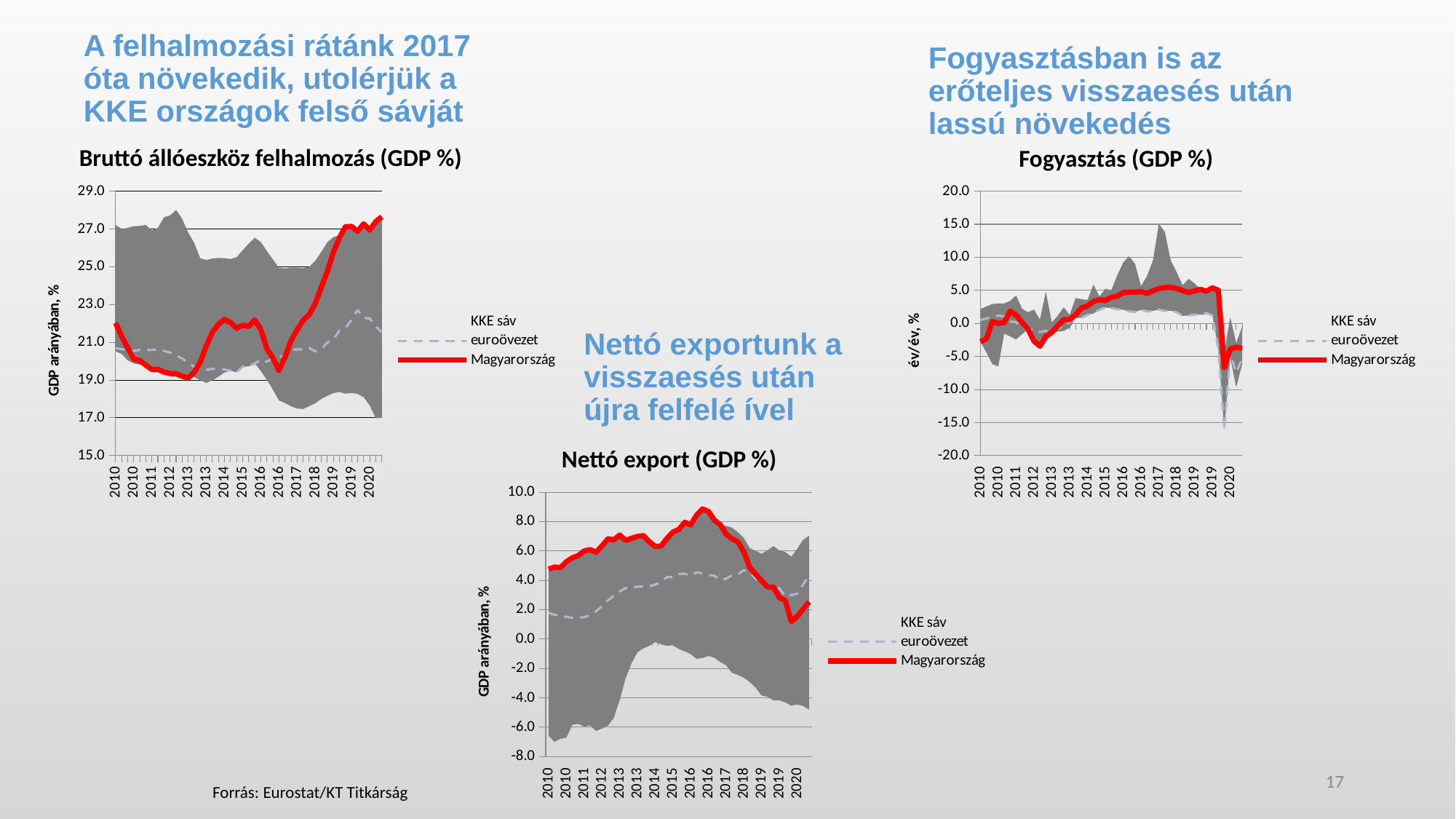
What kind of chart is the 'Bruttó állóeszköz felhalmozás (GDP %)' chart? combination area and line chart In the 'Bruttó állóeszköz felhalmozás (GDP %)' chart, is the value for Magyarország at the end of 2020 greater or less than 25.0? greater In the 'Nettó export (GDP %)' chart, is the value for Magyarország in 2020 greater or less than 4.0? less What is the y-axis label of the 'Fogyasztás (GDP %)' chart? év/év, % In the 'Nettó export (GDP %)' chart, is the peak value for Magyarország in 2016 greater or less than 8.0? greater In the 'Bruttó állóeszköz felhalmozás (GDP %)' chart, what colour is the Magyarország line? red In the 'Nettó export (GDP %)' chart, which series is higher in 2016, Magyarország or euroövezet? Magyarország In the 'Bruttó állóeszköz felhalmozás (GDP %)' chart, does the Magyarország line rise or fall from 2017 to 2020? rise How many series does the legend of the 'Nettó export (GDP %)' chart list? 3